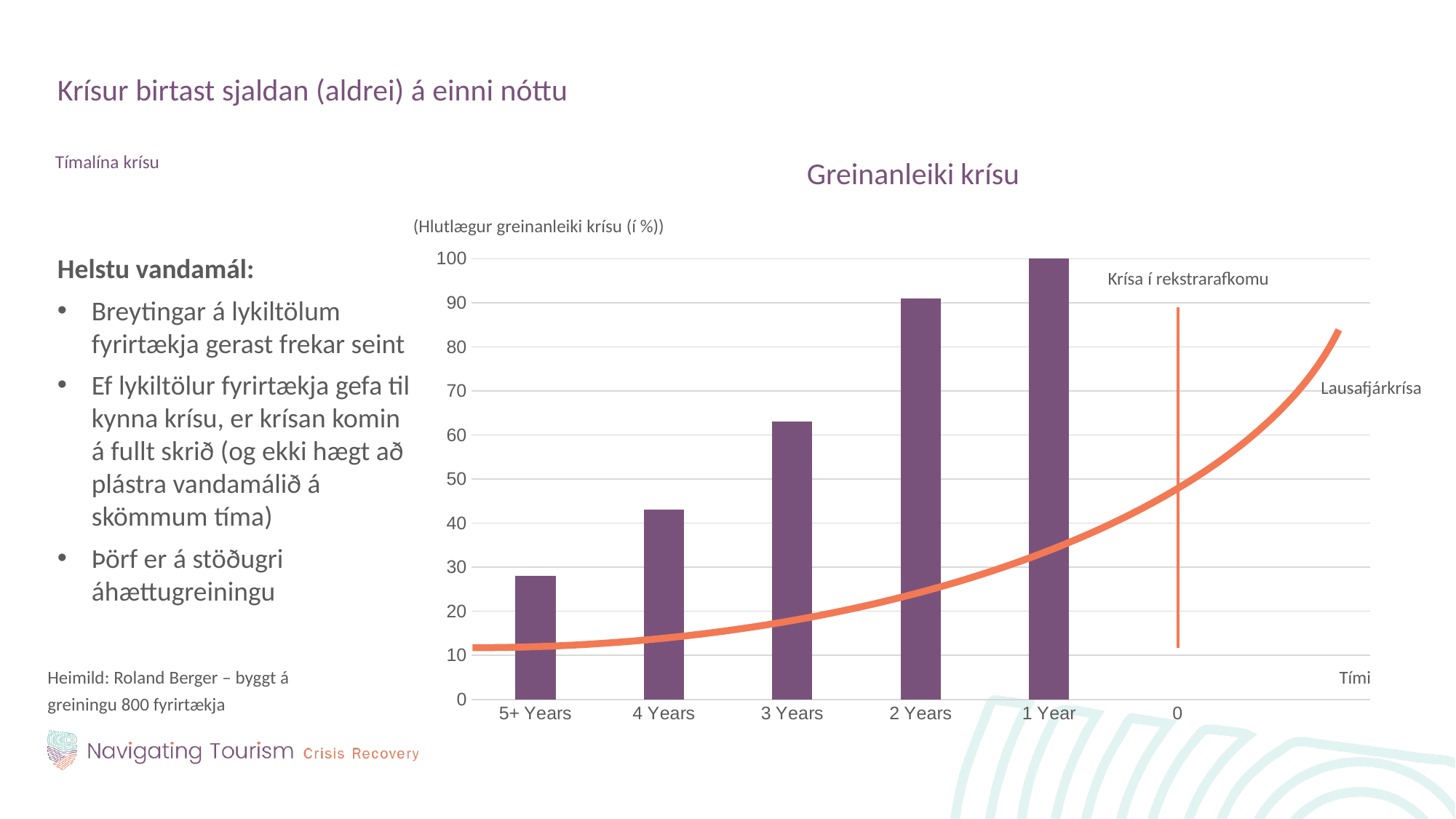
Do the bar values rise or fall moving from 5+ Years toward 1 Year along the x axis? rise Is the value for 5+ Years greater or less than 30? less Is the value for 3 Years greater or less than 60? greater How many bars are plotted in the chart? 5 What is the title of the chart? Greinanleiki krísu Is the value for 4 Years greater or less than 40? greater What is the value of the bar for 1 Year? 100 Which category has the highest bar? 1 Year Which is larger, the bar for 3 Years or the bar for 4 Years? 3 Years What type of chart is shown under the title "Greinanleiki krísu"? bar chart Which category has the lowest bar? 5+ Years